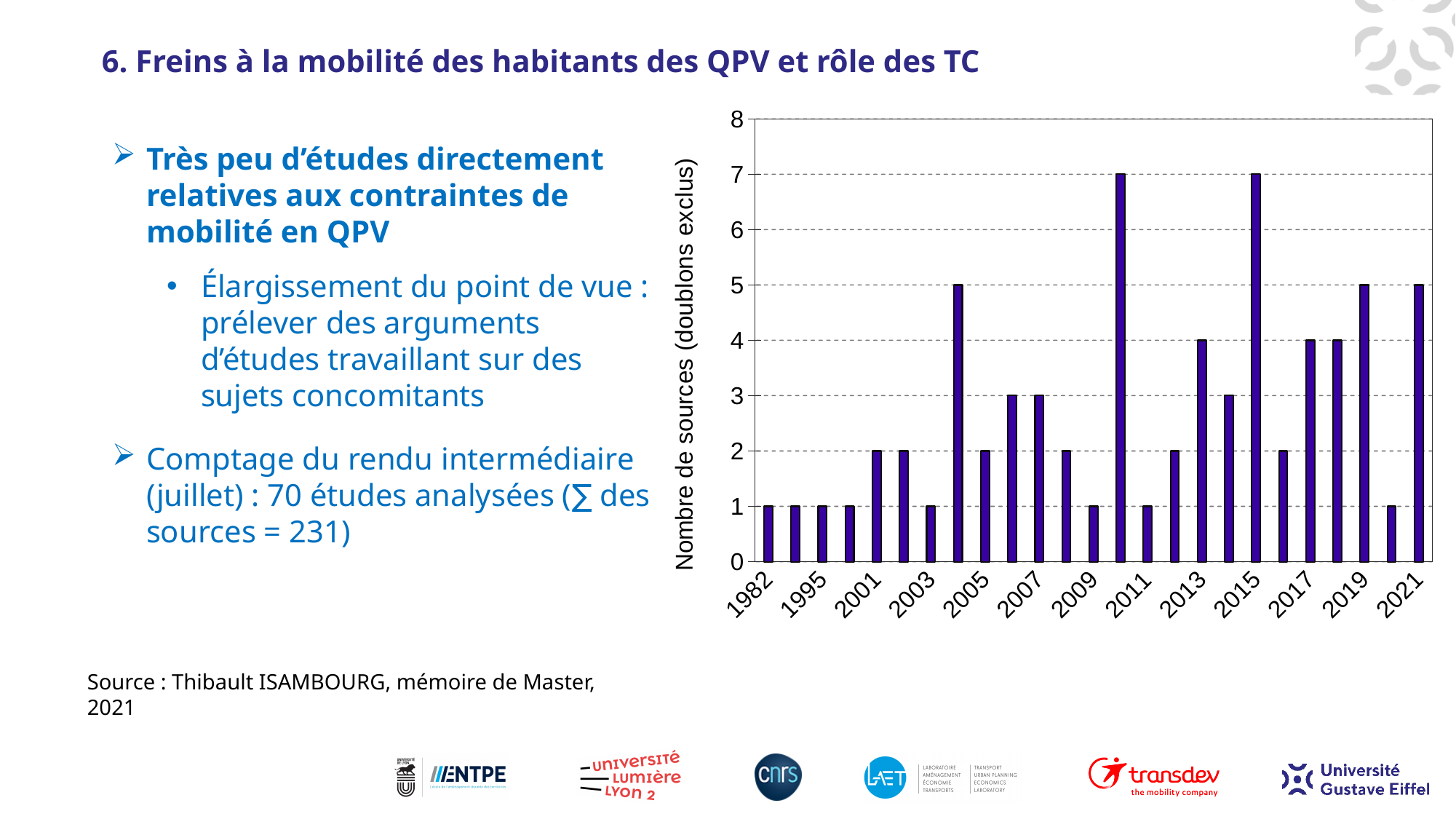
What is the number of sources for 1982? 1 What is the number of sources for 2021? 5 Is the value for 2015 greater or less than 6? greater What is the number of sources for 2015? 7 What is the number of sources for 2013? 4 What is the number of sources for 2019? 5 What type of chart is shown on the slide? bar chart How many year labels are shown on the x axis? 13 What is the difference in number of sources between 2015 and 2013? 3 What is the title of the y axis? Nombre de sources (doublons exclus) Which year has more sources, 2015 or 2013? 2015 What is the number of sources for 2007? 3